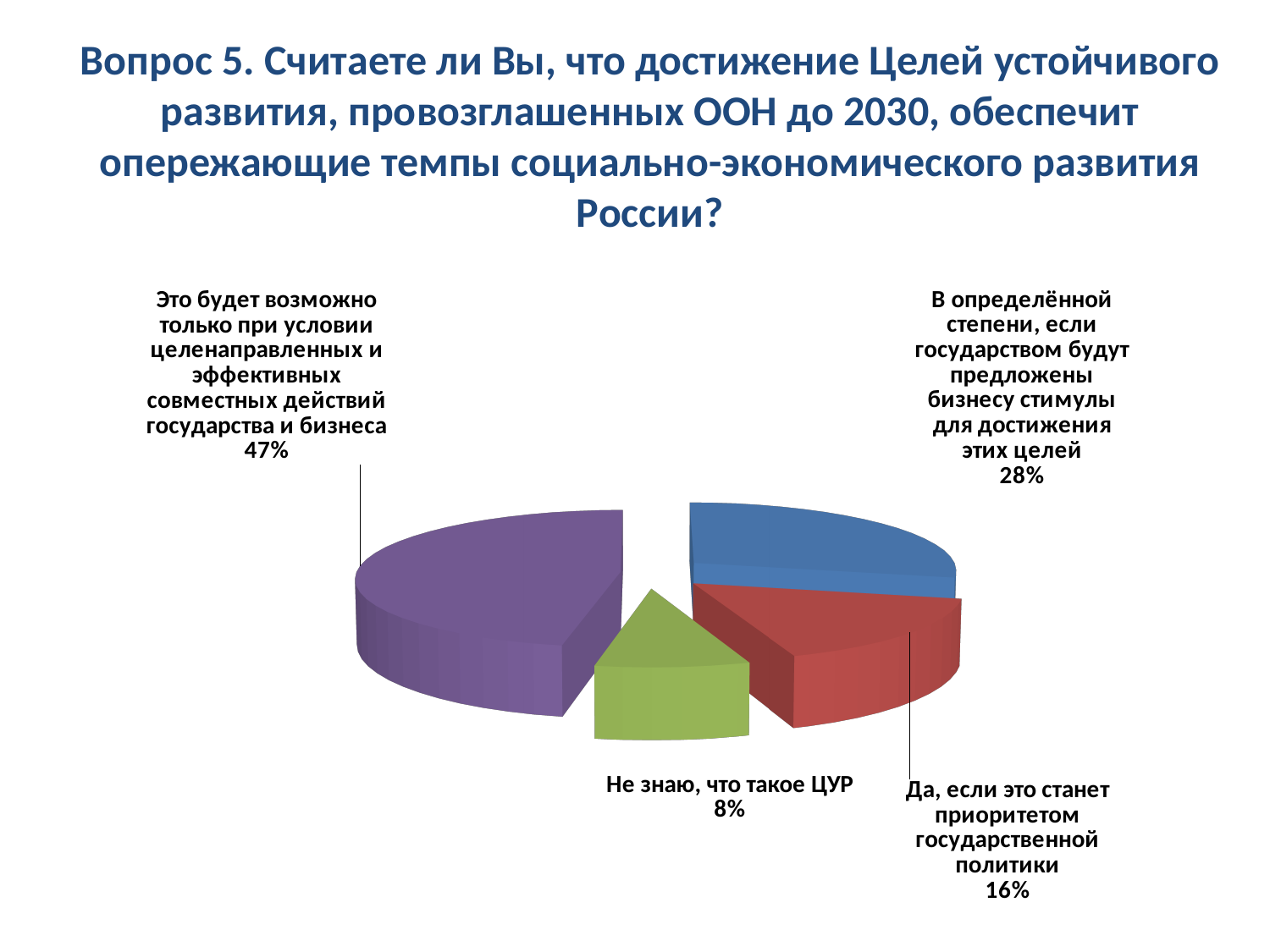
What share of respondents answered "В определённой степени, если государством будут предложены бизнесу стимулы для достижения этих целей"? 28% What kind of chart is shown on the slide? pie chart What is the difference in percentage points between the "47%" slice and the "28%" slice? 19 percentage points What share of respondents answered "Это будет возможно только при условии целенаправленных и эффективных совместных действий государства и бизнеса"? 47% What share of respondents answered "Не знаю, что такое ЦУР"? 8% Which answer option has the smallest share in the pie chart? Не знаю, что такое ЦУР How many slices does the pie chart have? 4 What colour is the slice representing 47%? purple Which is larger: the share for "Да, если это станет приоритетом государственной политики" or the share for "Не знаю, что такое ЦУР"? Да, если это станет приоритетом государственной политики What colour is the slice representing 8%? green What share of respondents answered "Да, если это станет приоритетом государственной политики"? 16% Which answer option has the largest share in the pie chart? Это будет возможно только при условии целенаправленных и эффективных совместных действий государства и бизнеса